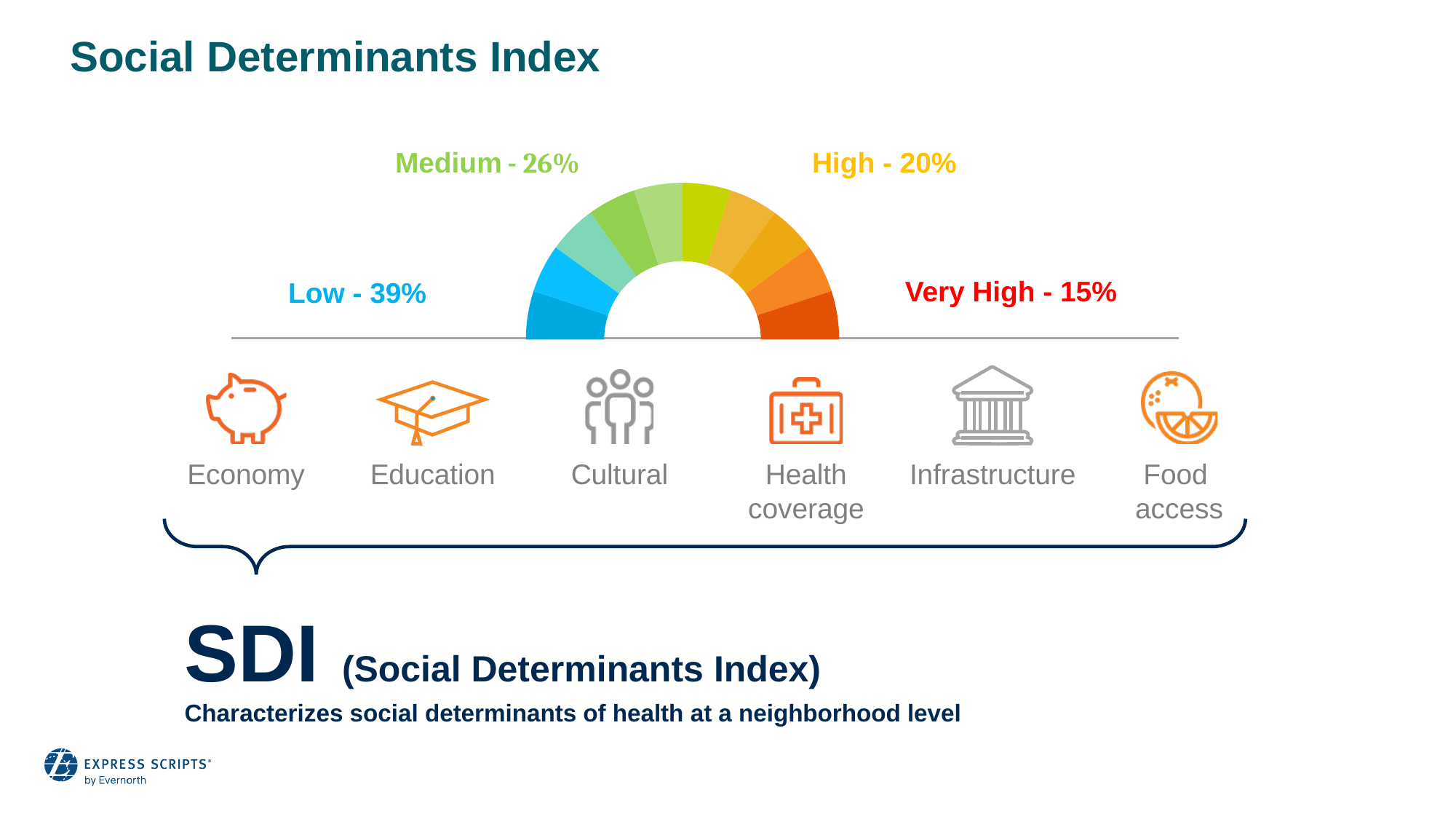
How many categories are shown on the gauge chart? 4 Which is larger, the Medium percentage or the High percentage? Medium What is the difference between the Medium and High percentages? 6% What percentage is shown for the Medium category? 26% What percentage is shown for the Very High category? 15% Which category has the lowest percentage on the gauge? Very High What kind of chart is used to show the Low, Medium, High and Very High percentages? A semicircular doughnut (gauge) chart What colour is used for the Very High category on the gauge? Red/orange-red What is the difference between the Low and Very High percentages? 24% Which category has the highest percentage on the gauge? Low What percentage is shown for the Low category on the Social Determinants Index gauge? 39% What percentage is shown for the High category? 20%